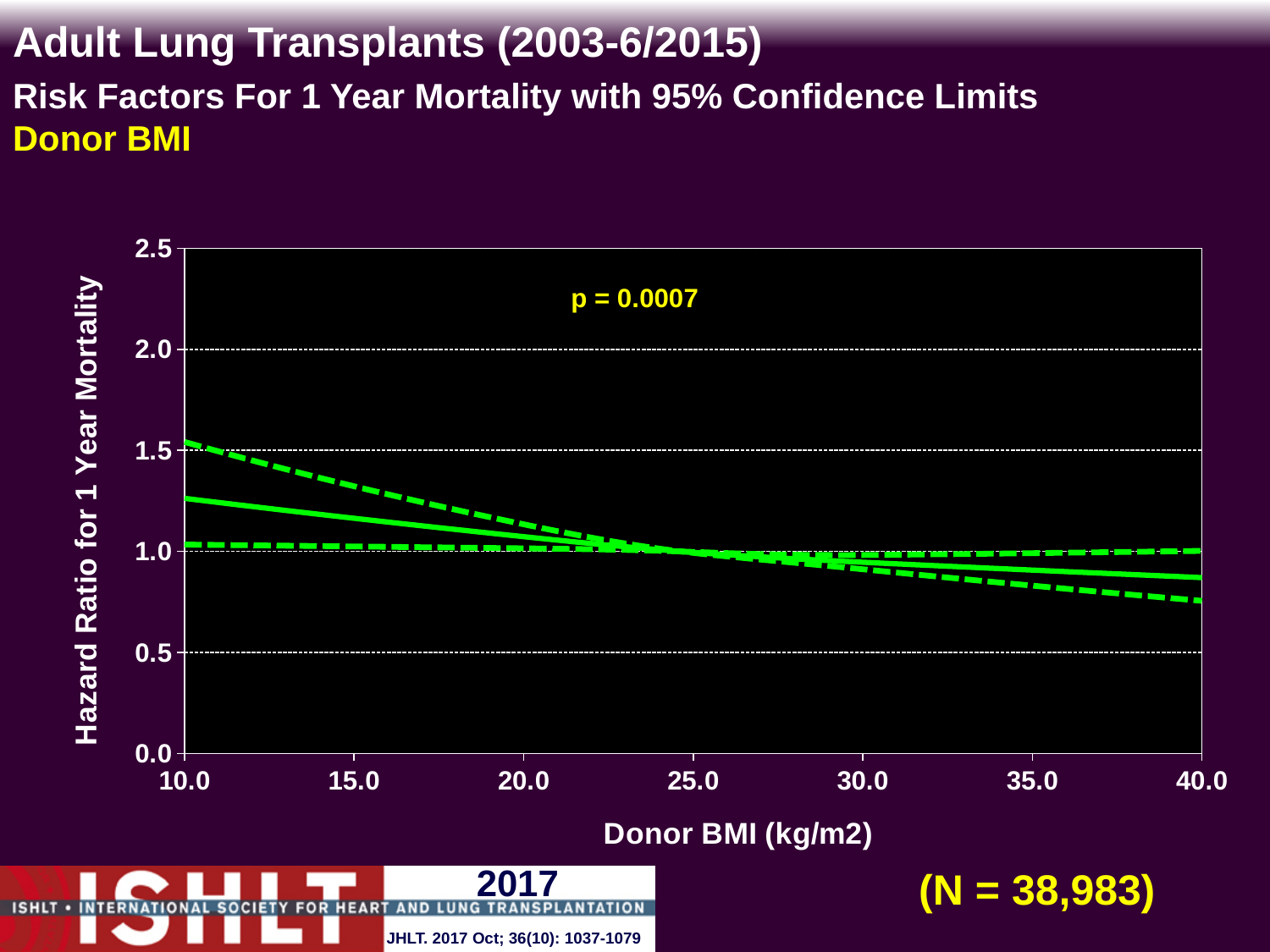
Is the upper dashed confidence limit at a donor BMI of 10.0 greater or less than 1.0? greater Does the solid hazard ratio line rise or fall as donor BMI increases from 10.0 to 40.0? fall Is the lower dashed confidence limit at a donor BMI of 40.0 greater or less than 1.0? less Is the hazard ratio on the solid line at a donor BMI of 10.0 greater or less than 1.0? greater What kind of chart is shown on the slide? line chart What p-value is printed on the chart? p = 0.0007 How many lines are plotted on the chart? 3 What is the label of the x axis? Donor BMI (kg/m2) Is the solid hazard ratio line higher at a donor BMI of 10.0 or at 40.0? 10.0